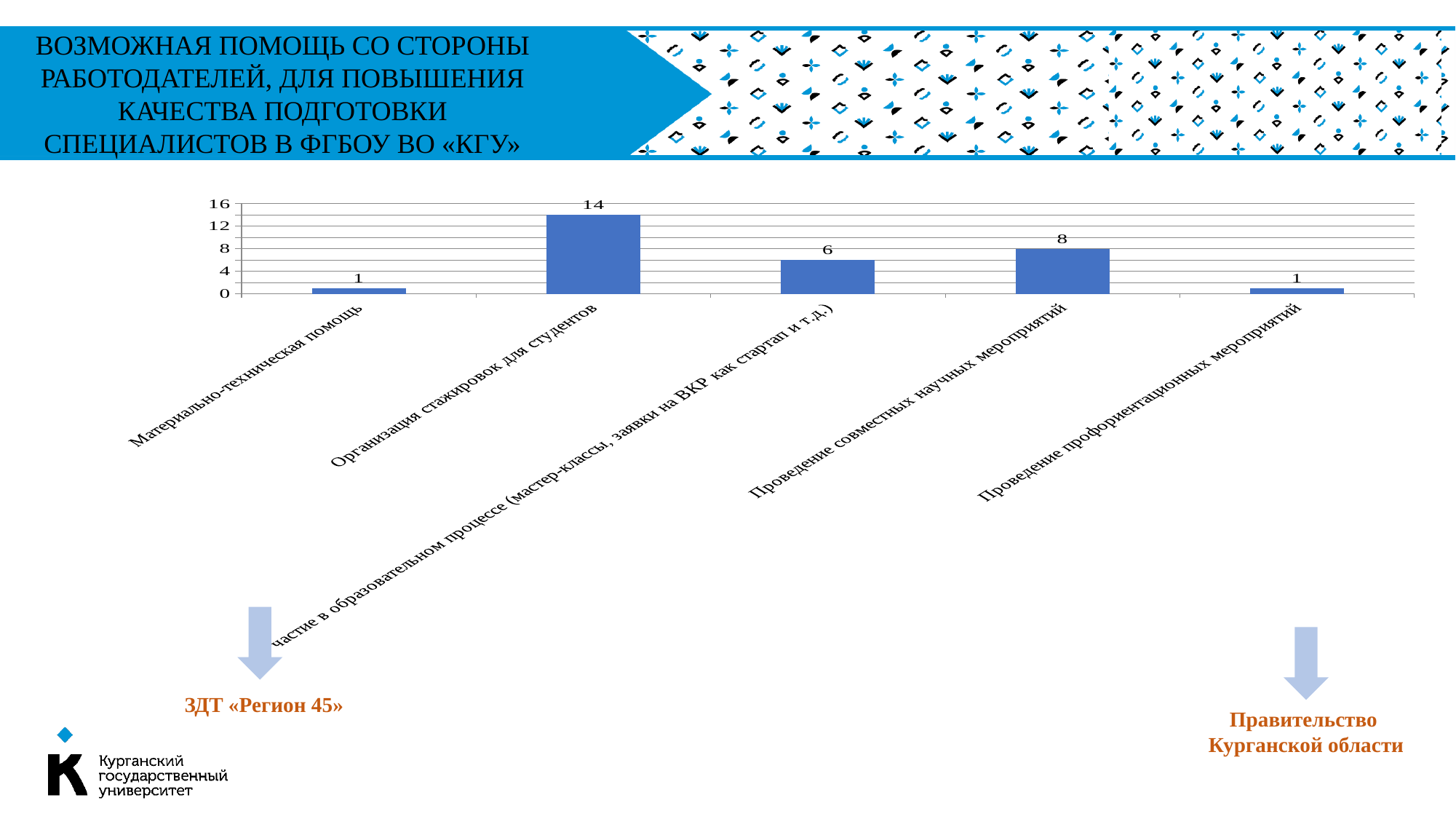
What is the value for «Организация стажировок для студентов»? 14 What is the value for «Материально-техническая помощь»? 1 How many categories are shown on the x axis of the chart? 5 Is the value for «Организация стажировок для студентов» greater or less than 12? greater Which category has the highest value? Организация стажировок для студентов What is the value for «Проведение совместных научных мероприятий»? 8 What kind of chart is shown on the slide? bar chart What is the difference between the values for «Организация стажировок для студентов» and «Проведение совместных научных мероприятий»? 6 What is the maximum value shown on the chart's vertical axis? 16 What is the value for «Участие в образовательном процессе (мастер-классы, заявки на ВКР как стартап и т.д.)»? 6 Which is larger: the value for «Проведение совместных научных мероприятий» or the value for «Участие в образовательном процессе (мастер-классы, заявки на ВКР как стартап и т.д.)»? Проведение совместных научных мероприятий What is the difference between the values for «Участие в образовательном процессе (мастер-классы, заявки на ВКР как стартап и т.д.)» and «Проведение профориентационных мероприятий»? 5